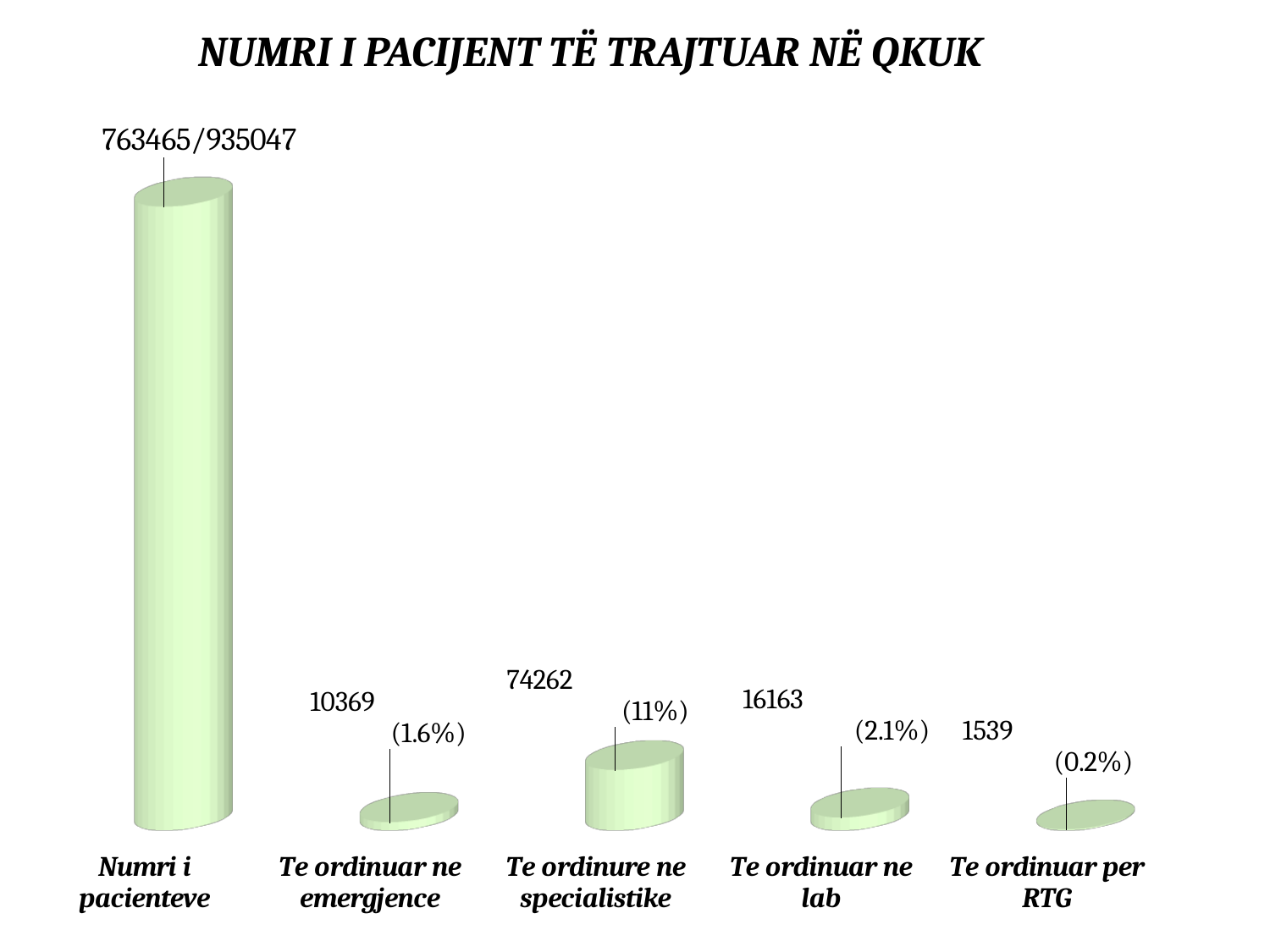
What percentage is shown next to 'Te ordinuar per RTG'? 0.2% What value is labelled for 'Te ordinuar ne lab'? 16163 What value is labelled for 'Te ordinure ne specialistike'? 74262 What percentage is shown next to 'Te ordinure ne specialistike'? 11% What value is labelled for 'Te ordinuar ne emergjence'? 10369 What is the difference between the values for 'Te ordinure ne specialistike' and 'Te ordinuar ne lab'? 58099 How many categories are plotted in the chart? 5 What value is labelled for 'Te ordinuar per RTG'? 1539 What is the chart's title? NUMRI I PACIJENT TË TRAJTUAR NË QKUK Which category has the lowest value? Te ordinuar per RTG What kind of chart is shown on the slide? bar chart Which category has the highest value? Numri i pacienteve